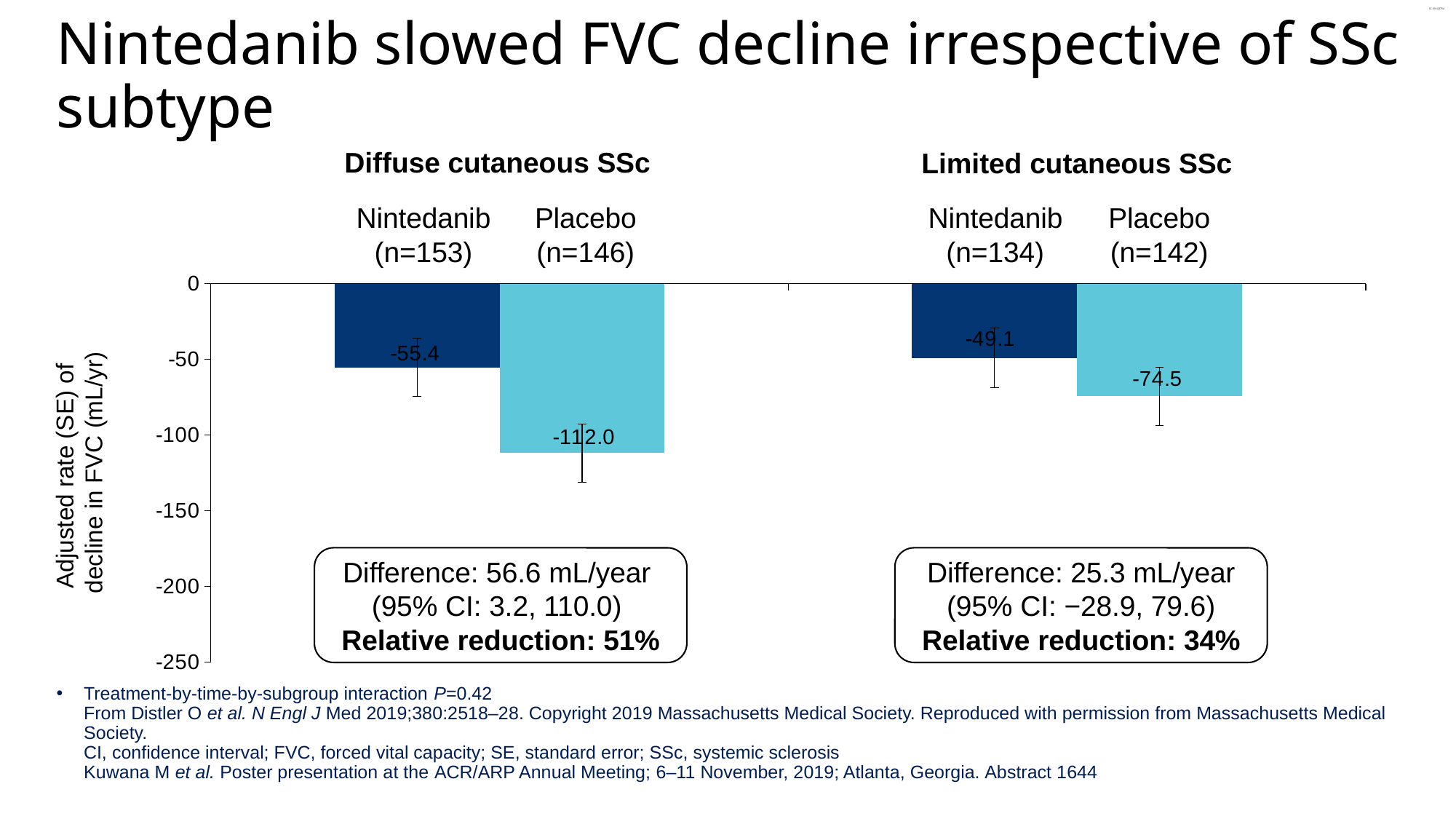
In the Diffuse cutaneous SSc group, which arm has the greater decline in FVC, Nintedanib or Placebo? Placebo Is the Placebo value in the Diffuse cutaneous SSc group below -100 on the axis? Yes What is the label of the vertical axis? Adjusted rate (SE) of decline in FVC (mL/yr) How many bars are plotted in the chart? 4 What is the adjusted rate of decline in FVC for Placebo in the Diffuse cutaneous SSc group? -112.0 What is the adjusted rate of decline in FVC for Placebo in the Limited cutaneous SSc group? -74.5 Which bar shows the smallest decline in FVC (least negative value)? Nintedanib, Limited cutaneous SSc What is the adjusted rate of decline in FVC for Nintedanib in the Limited cutaneous SSc group? -49.1 Which bar shows the largest decline in FVC (most negative value)? Placebo, Diffuse cutaneous SSc What is the adjusted rate of decline in FVC for Nintedanib in the Diffuse cutaneous SSc group? -55.4 What type of chart is shown on the slide? Bar chart What is the difference between the Placebo and Nintedanib values in the Limited cutaneous SSc group? 25.4